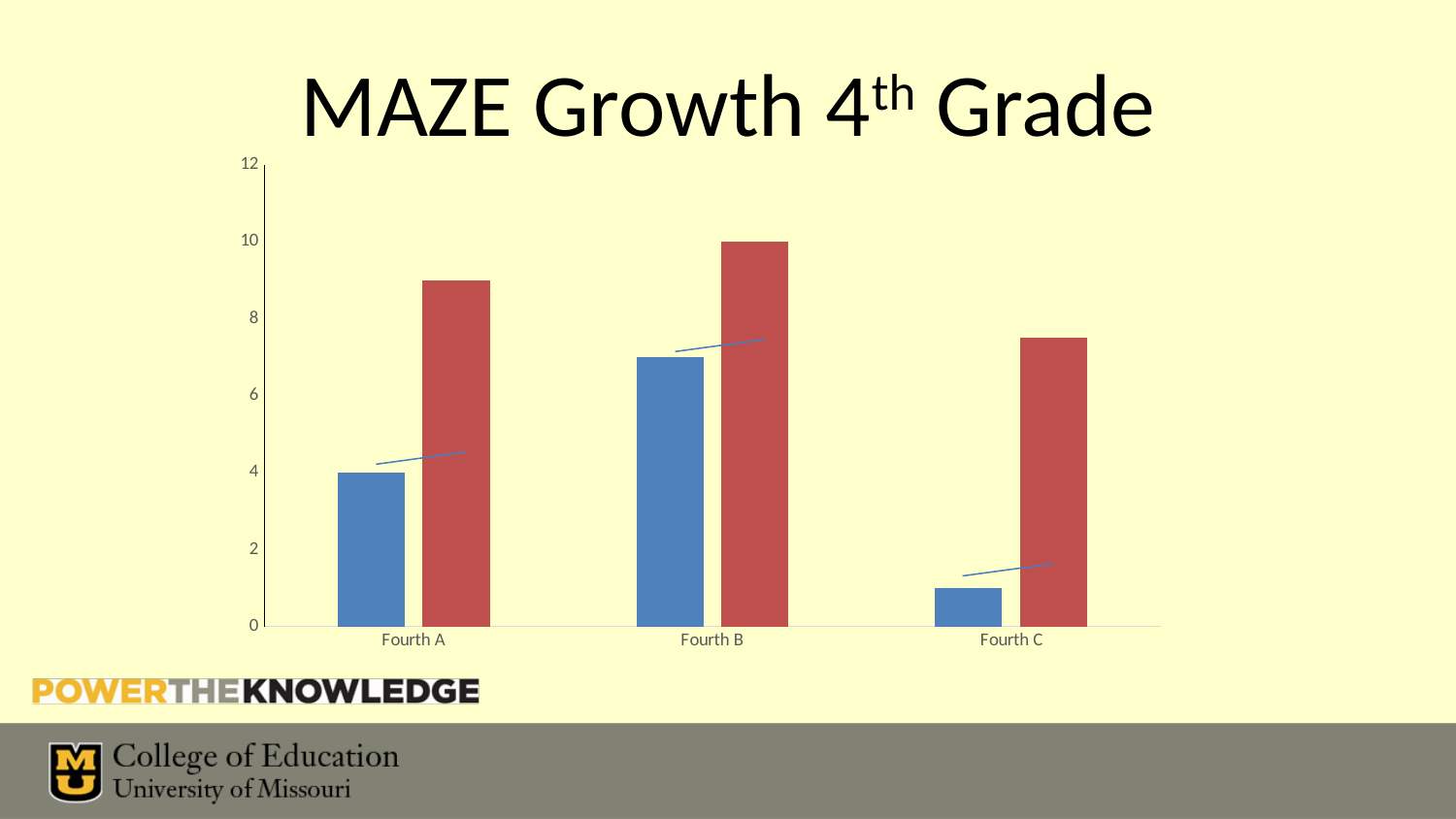
Is the red bar for Fourth C greater or less than 8? less Is the blue bar for Fourth B greater or less than 6? greater What is the title of the chart? MAZE Growth 4th Grade Is the blue bar for Fourth C greater or less than 2? less What kind of chart is shown on the slide? bar chart Which category has the tallest red bar? Fourth B How many categories are shown on the x axis? 3 Which category has the shortest blue bar? Fourth C For Fourth A, which bar is taller, the blue bar or the red bar? red bar How many bars are plotted for each category? 2 Which category has the tallest blue bar? Fourth B